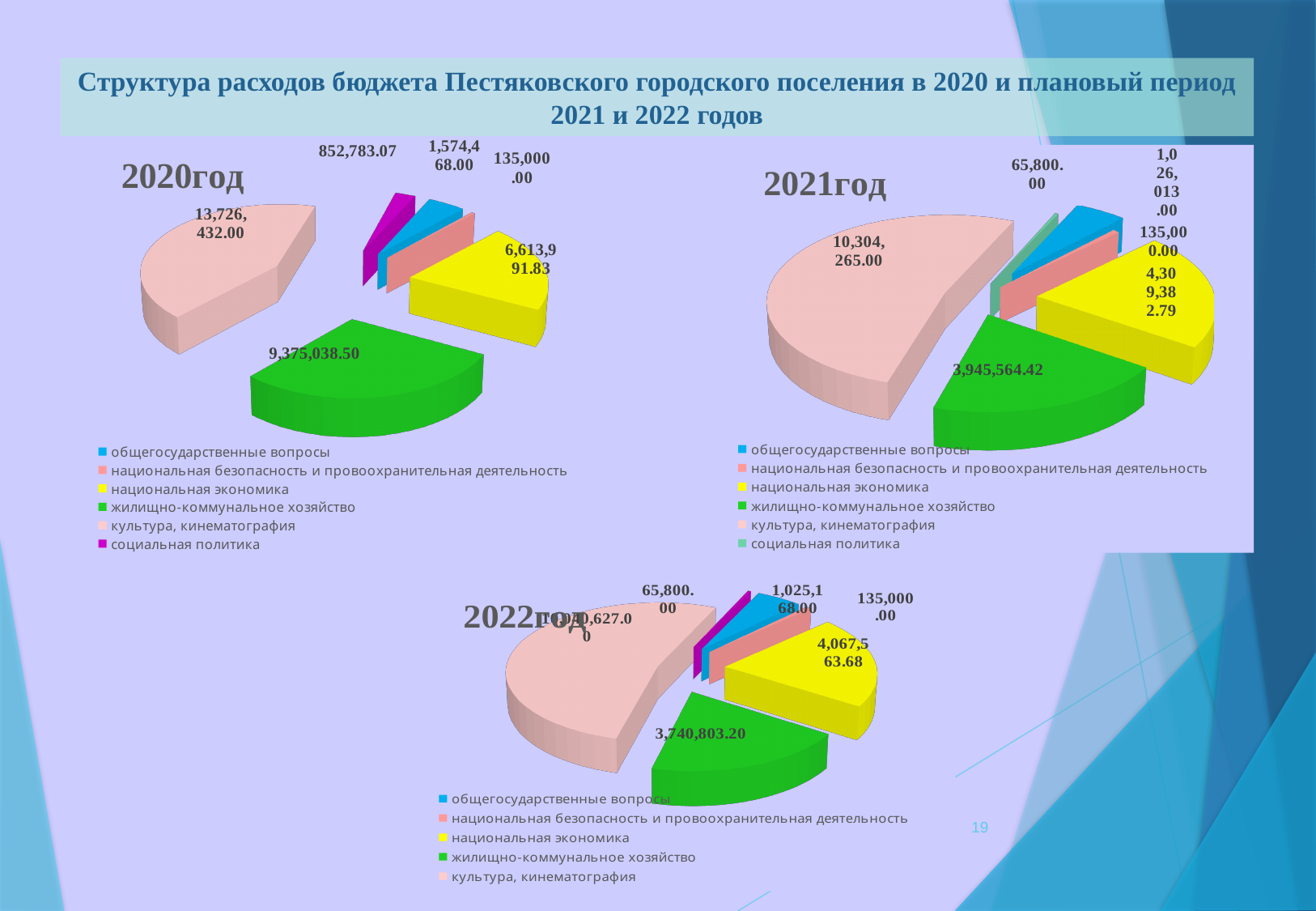
On the 2021год chart, what is the difference between национальная экономика and жилищно-коммунальное хозяйство? 363,818.37 What kind of chart is the 2020год chart? pie chart How many entries does the legend of the 2022год chart list? 5 On the 2022год chart, what is the value for жилищно-коммунальное хозяйство? 3,740,803.20 On the 2020год chart, what is the value for жилищно-коммунальное хозяйство? 9,375,038.50 On the 2020год chart, which category has the largest slice? культура, кинематография On the 2021год chart, what is the value for жилищно-коммунальное хозяйство? 3,945,564.42 On the 2021год chart, which is larger: национальная экономика or жилищно-коммунальное хозяйство? национальная экономика On the 2020год chart, what is the value for национальная экономика? 6,613,991.83 On the 2020год chart, which category has the smallest slice? национальная безопасность и провоохранительная деятельность On the 2022год chart, what is the value for национальная экономика? 4,067,563.68 On the 2021год chart, what is the value for культура, кинематография? 10,304,265.00